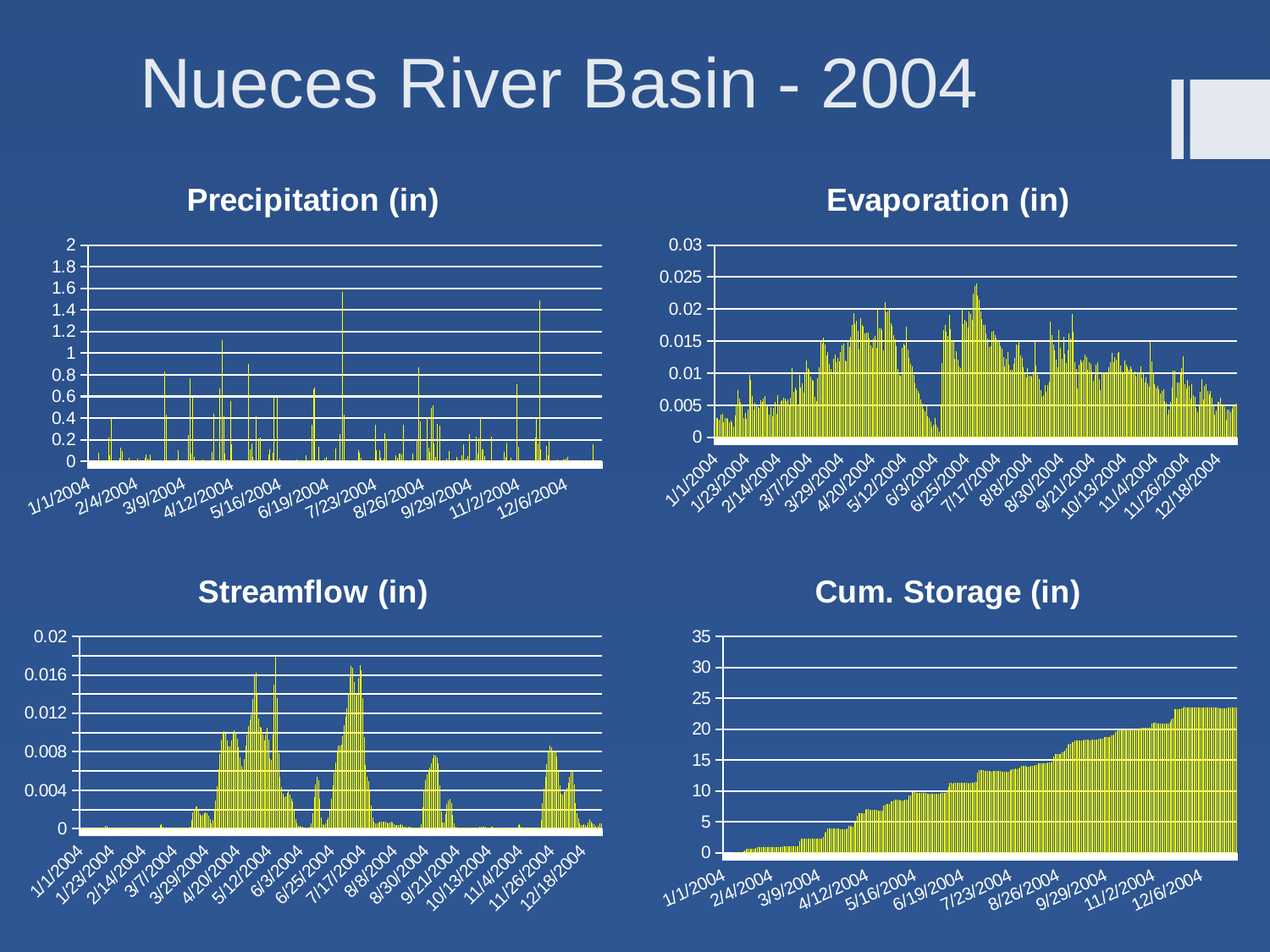
In the Streamflow (in) chart, is the highest peak (around 7/17/2004) greater or less than 0.012? greater In the Evaporation (in) chart, is evaporation higher around 7/17/2004 or around 12/18/2004? 7/17/2004 What kind of chart is the Precipitation (in) chart? bar chart How many charts are shown on the slide? 4 In the Cum. Storage (in) chart, is the value at 1/1/2004 greater or less than 5? less In the Precipitation (in) chart, is the tallest spike (around 7/23/2004) greater or less than 1? greater In the Cum. Storage (in) chart, do the values rise or fall along the x axis over the year? rise What is the title of the chart in the bottom-right of the slide? Cum. Storage (in)